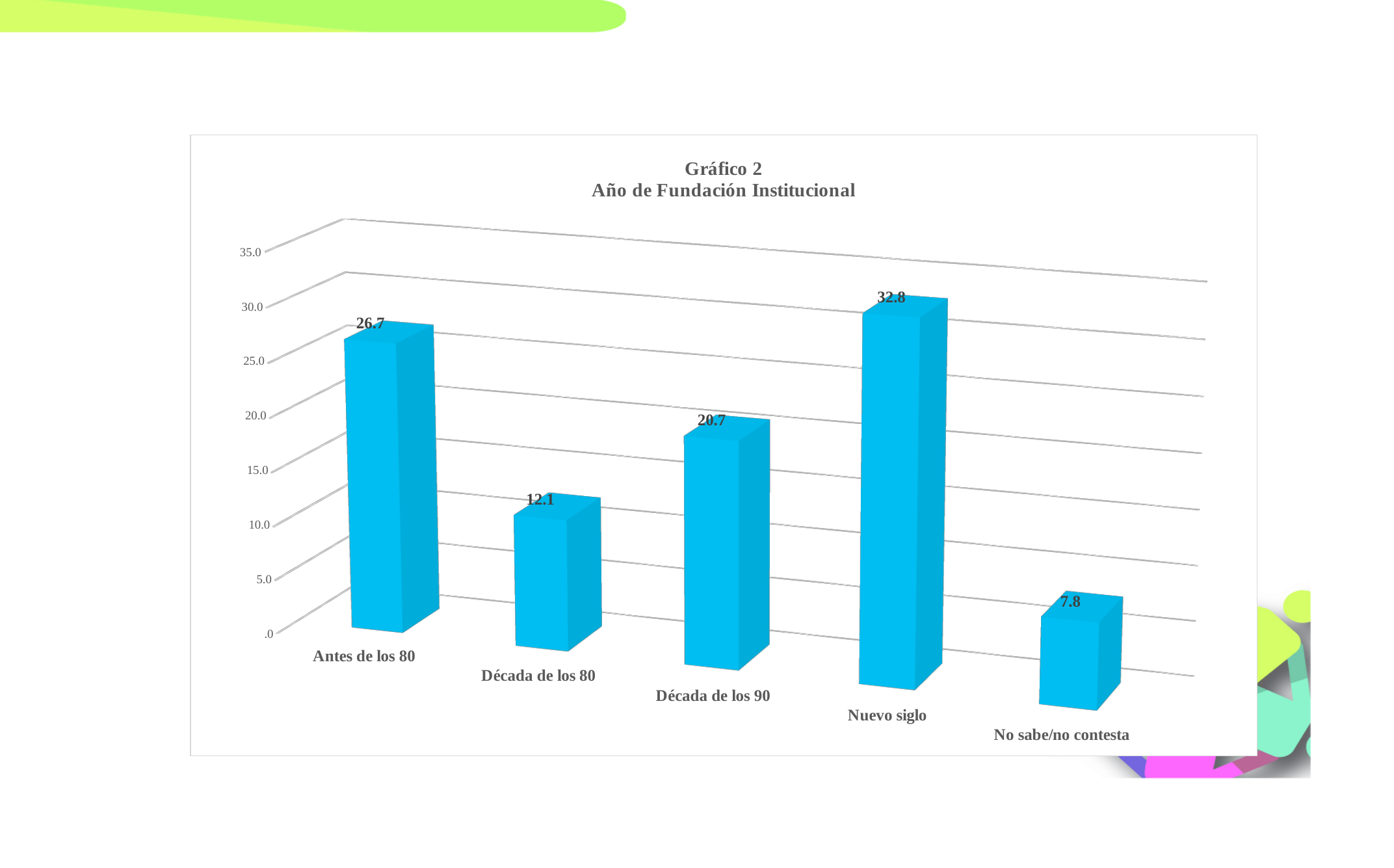
What is the value for No sabe/no contesta? 7.8 Which is larger, the value for Década de los 90 or the value for Década de los 80? Década de los 90 What is the value for Antes de los 80? 26.7 What is the difference between the values for Nuevo siglo and Antes de los 80? 6.1 Which category has the highest value? Nuevo siglo What is the value for Década de los 90? 20.7 What kind of chart is shown on the slide? Bar chart What is the value for Nuevo siglo? 32.8 What is the value for Década de los 80? 12.1 How many categories are shown in the chart? 5 Which category has the lowest value? No sabe/no contesta What is the title of the chart? Gráfico 2 Año de Fundación Institucional